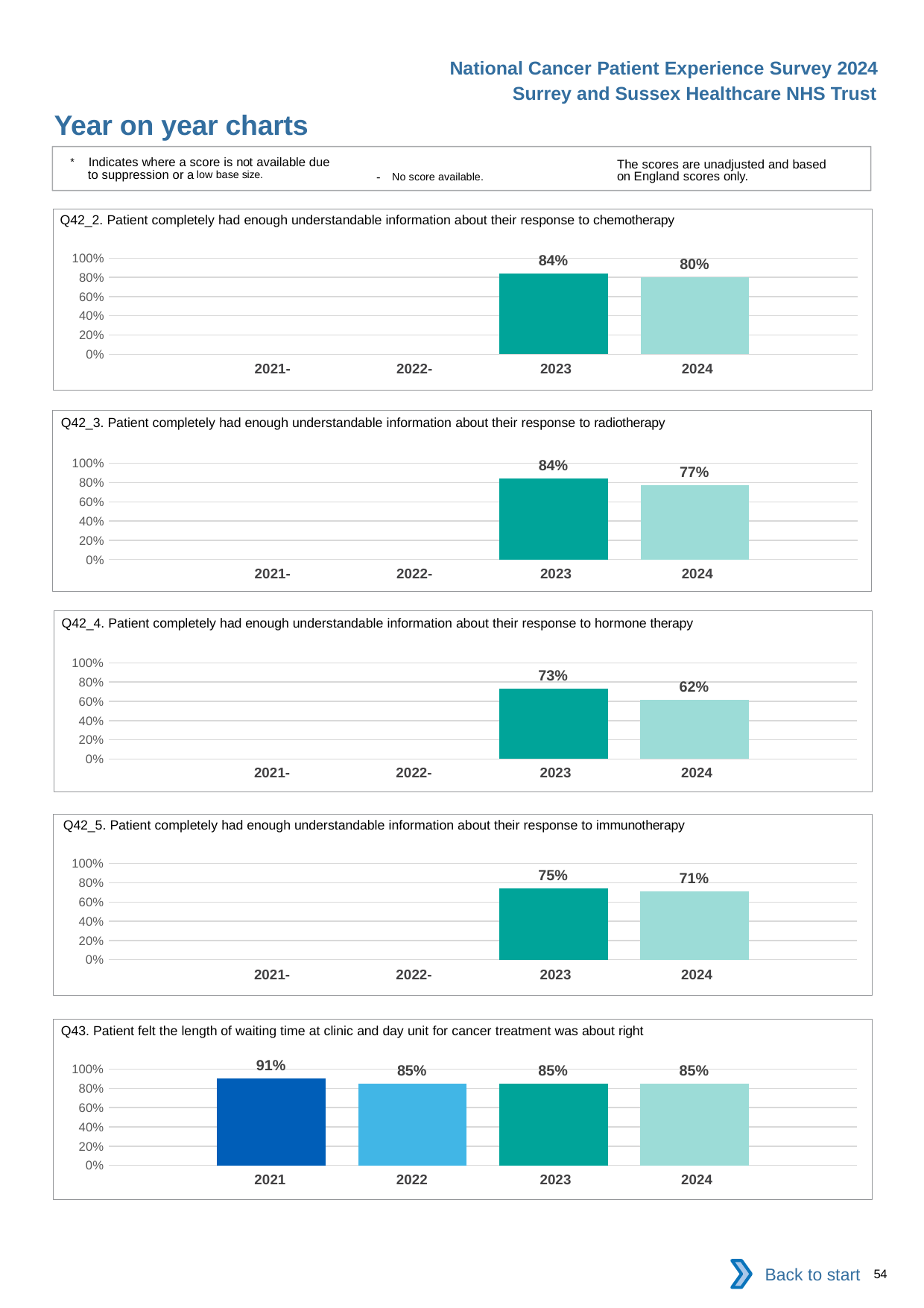
In the Q42_4 chart (hormone therapy), what is the difference between the 2023 and 2024 values? 11 percentage points In the Q42_2 chart (chemotherapy), what is the value for 2024? 80% In the Q42_5 chart (immunotherapy), which year has the higher value, 2023 or 2024? 2023 In the Q43 chart (waiting time at clinic and day unit), how many years have a plotted bar? 4 In the Q43 chart (waiting time at clinic and day unit), which year has the highest value? 2021 In the Q42_2 chart (chemotherapy), what is the difference between the 2023 and 2024 values? 4 percentage points In the Q42_3 chart (radiotherapy), do the values rise or fall from 2023 to 2024? Fall In the Q42_2 chart (chemotherapy), how many years have a plotted bar? 2 In the Q43 chart (waiting time at clinic and day unit), what is the value for 2022? 85% In the Q42_3 chart (radiotherapy), what is the value for 2023? 84% What kind of chart is the Q43 chart (waiting time at clinic and day unit)? Bar chart In the Q42_4 chart (hormone therapy), is the value for 2024 greater or less than 80%? less